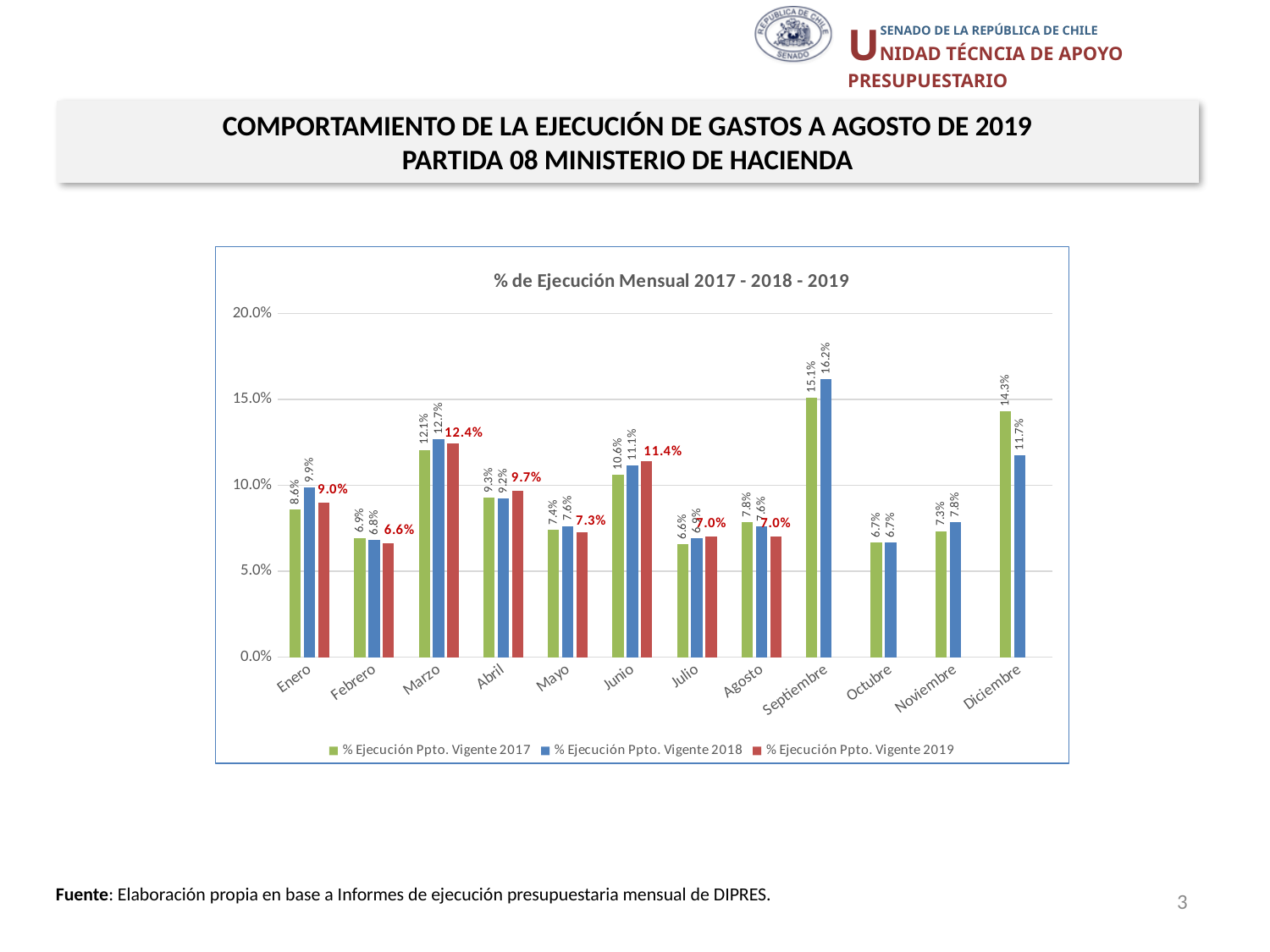
Which month has the lowest value for % Ejecución Ppto. Vigente 2019? Febrero What is the value for % Ejecución Ppto. Vigente 2018 in Septiembre? 16.2% What is the value for % Ejecución Ppto. Vigente 2019 in Marzo? 12.4% Is the value for % Ejecución Ppto. Vigente 2018 in Septiembre greater or less than 15.0%? greater What is the difference between the 2018 and 2017 values in Septiembre? 1.1 percentage points How many months are shown on the x axis? 12 How many series does the legend list? 3 What is the value for % Ejecución Ppto. Vigente 2019 in Junio? 11.4% Which month has the highest value for % Ejecución Ppto. Vigente 2017? Septiembre What kind of chart is shown on the slide? Bar chart In Diciembre, which series has the larger value, 2017 or 2018? % Ejecución Ppto. Vigente 2017 What is the title of the chart? % de Ejecución Mensual 2017 - 2018 - 2019